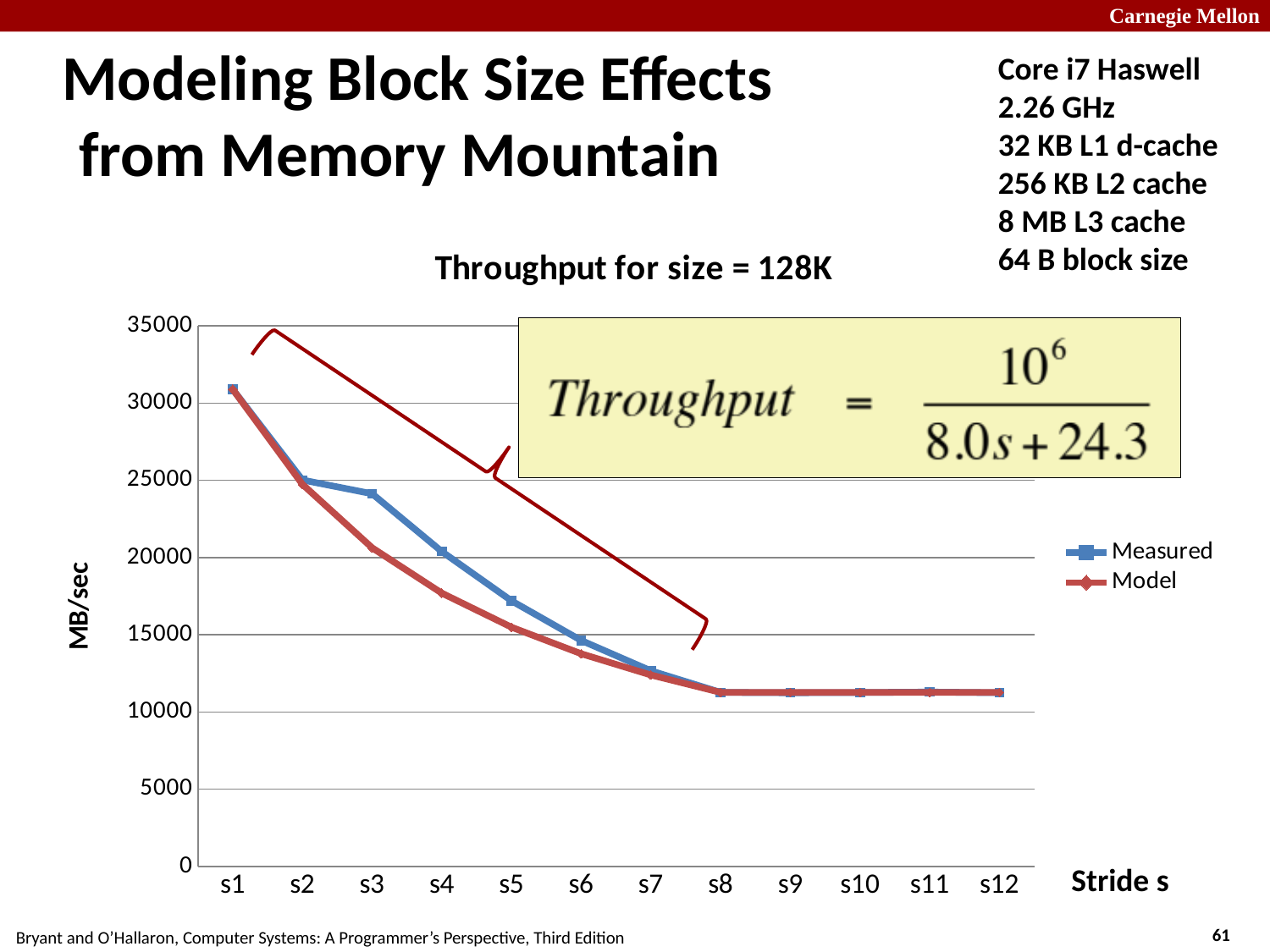
Is the Measured value at s8 greater or less than 15000? less How many series does the legend list? 2 Do the Measured values rise or fall as the stride increases from s1 to s8? fall At which stride is the Measured throughput highest? s1 What kind of chart is shown on the slide? line chart At stride s3, which series has the larger value, Measured or Model? Measured What is the label on the y axis? MB/sec What is the title of the chart? Throughput for size = 128K Is the Model value at s3 greater or less than 25000? less Is the Model value at s4 greater or less than 20000? less How many stride categories are plotted along the x axis? 12